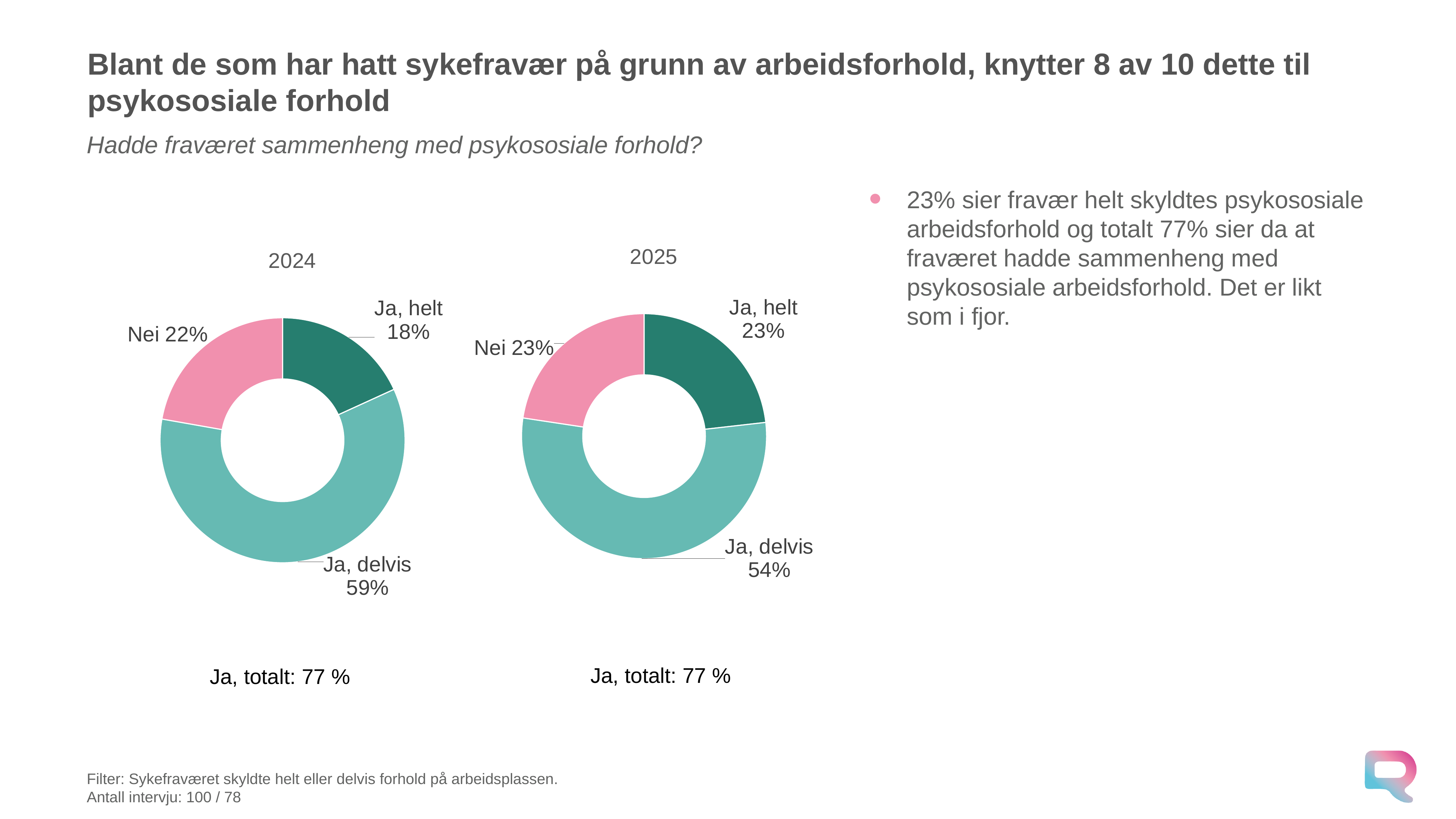
What colour is the "Nei" slice in both charts? Pink In the 2025 chart, what is the combined share of "Ja, helt" and "Ja, delvis"? 77% How many categories does each donut chart show? 3 What is the "Ja, totalt" value shown below the 2025 chart? 77 % What is the difference between the "Ja, delvis" shares in the 2024 chart and the 2025 chart? 5 percentage points In the 2024 chart, which category has the largest share? Ja, delvis In the 2025 chart, what percentage is shown for "Nei"? 23% Which is larger: "Ja, helt" in the 2024 chart or "Ja, helt" in the 2025 chart? 2025 In the 2025 chart, what percentage is shown for "Ja, delvis"? 54% What kind of charts are shown on the slide? Donut (pie) charts In the 2024 chart, which category has the smallest share? Ja, helt In the 2024 chart, what percentage is shown for "Ja, helt"? 18%